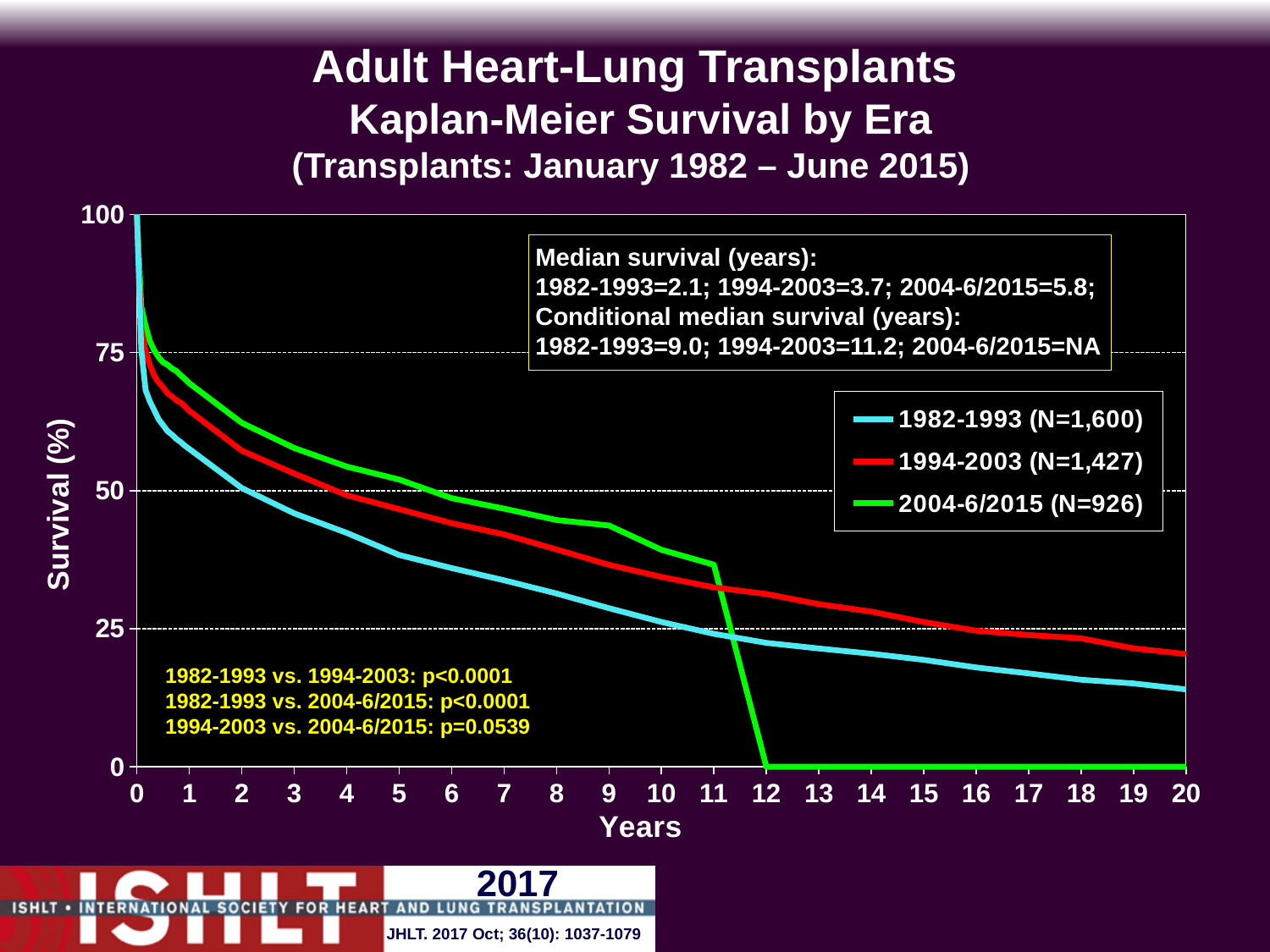
What is the difference in median survival (years) between the 2004-6/2015 era and the 1982-1993 era? 3.7 Which era has the lowest median survival? 1982-1993 What is the median survival in years for the 1994-2003 era? 3.7 How many series does the legend list? 3 Is the survival for the 1994-2003 era at 10 years greater or less than 25? greater At 5 years, which era has higher survival, 1982-1993 or 1994-2003? 1994-2003 Which era has the highest median survival? 2004-6/2015 What is the N for the 2004-6/2015 era in the legend? 926 Is the survival for the 1982-1993 era at 5 years greater or less than 50? less Do the survival curves rise or fall as years increase? fall What is the conditional median survival in years for the 1982-1993 era? 9.0 What kind of chart is shown on the slide? line chart